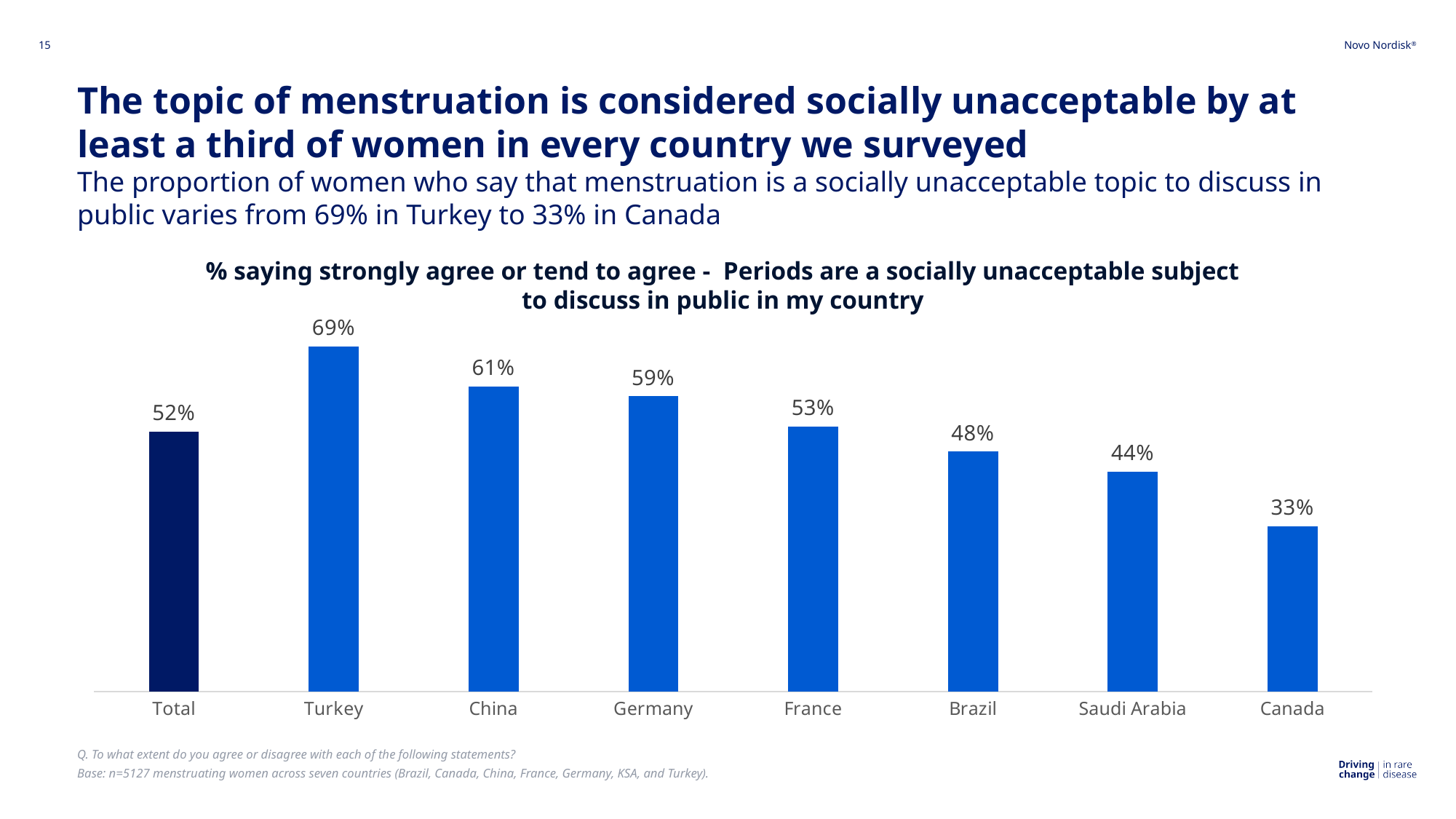
What type of chart is shown on the slide? Bar chart Which country has the lowest percentage? Canada Which country has the highest percentage? Turkey What is the value shown for Germany? 59% How many bars are shown in the chart? 8 Which has a higher value, Brazil or France? France Which bar is shown in a darker shade of blue than the others? Total What percentage of women in Turkey say periods are a socially unacceptable subject to discuss in public? 69% What is the difference in percentage points between China and France? 8 What is the value shown for Saudi Arabia? 44% What is the value shown for the Total bar? 52% What is the difference in percentage points between Turkey and Canada? 36